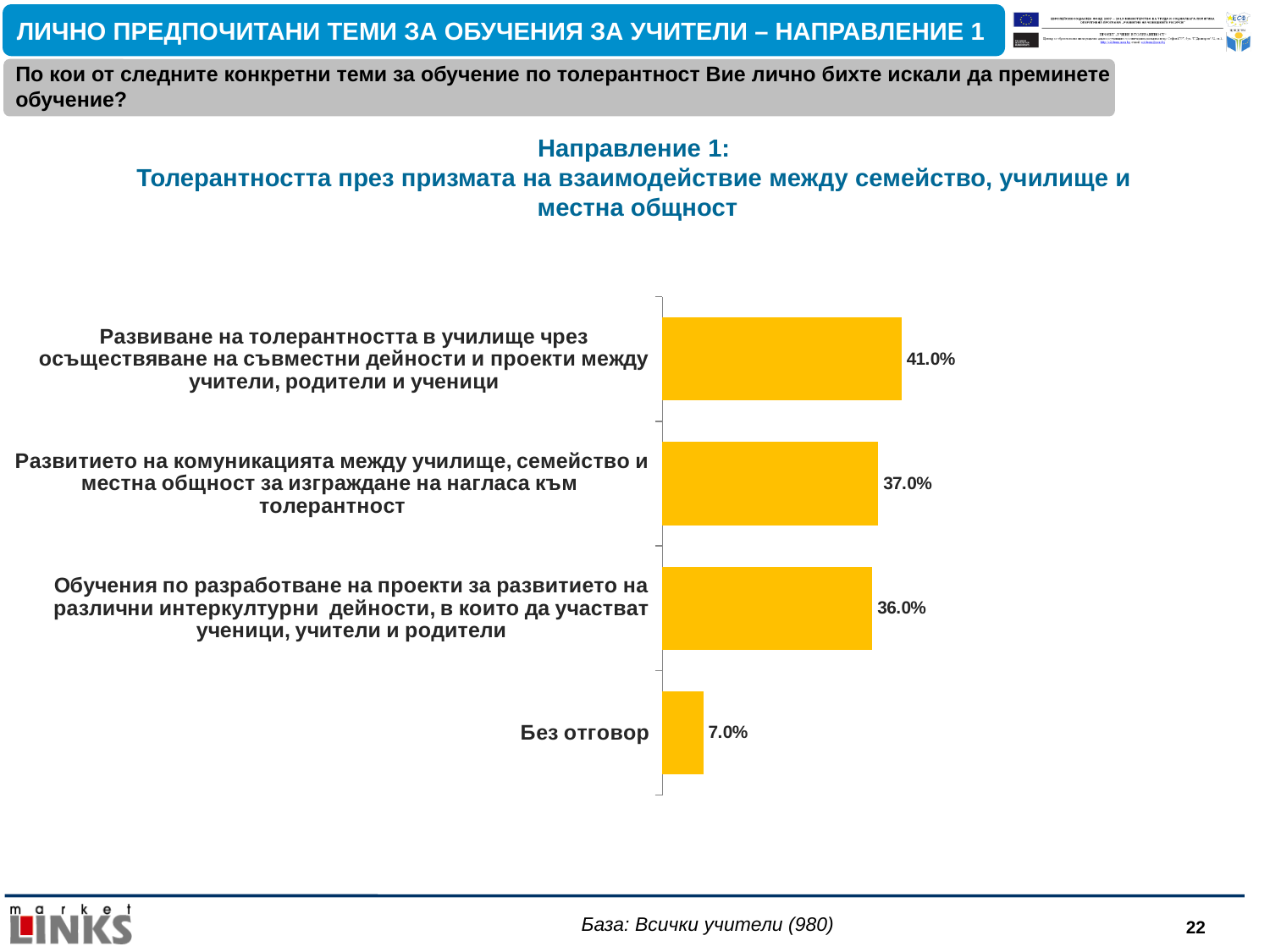
Which category has the highest value? Развиване на толерантността в училище чрез осъществяване на съвместни дейности и проекти между учители, родители и ученици Which category has the lowest value? Без отговор What is the value for "Развиване на толерантността в училище чрез осъществяване на съвместни дейности и проекти между учители, родители и ученици"? 41.0% How many categories are shown in the chart? 4 What kind of chart is shown on the slide? Bar chart What is the value for "Развитието на комуникацията между училище, семейство и местна общност за изграждане на нагласа към толерантност"? 37.0% Which is larger: the value for "Развиване на толерантността в училище чрез осъществяване на съвместни дейности и проекти между учители, родители и ученици" or the value for "Развитието на комуникацията между училище, семейство и местна общност за изграждане на нагласа към толерантност"? Развиване на толерантността в училище чрез осъществяване на съвместни дейности и проекти между учители, родители и ученици What colour are the bars in the chart? Yellow What is the value for "Без отговор"? 7.0% What is the difference between the value for "Развиване на толерантността в училище чрез осъществяване на съвместни дейности и проекти между учители, родители и ученици" and the value for "Без отговор"? 34.0% What is the difference between the values for "Развитието на комуникацията между училище, семейство и местна общност за изграждане на нагласа към толерантност" and "Обучения по разработване на проекти за развитието на различни интеркултурни дейности, в които да участват ученици, учители и родители"? 1.0% What is the value for "Обучения по разработване на проекти за развитието на различни интеркултурни дейности, в които да участват ученици, учители и родители"? 36.0%